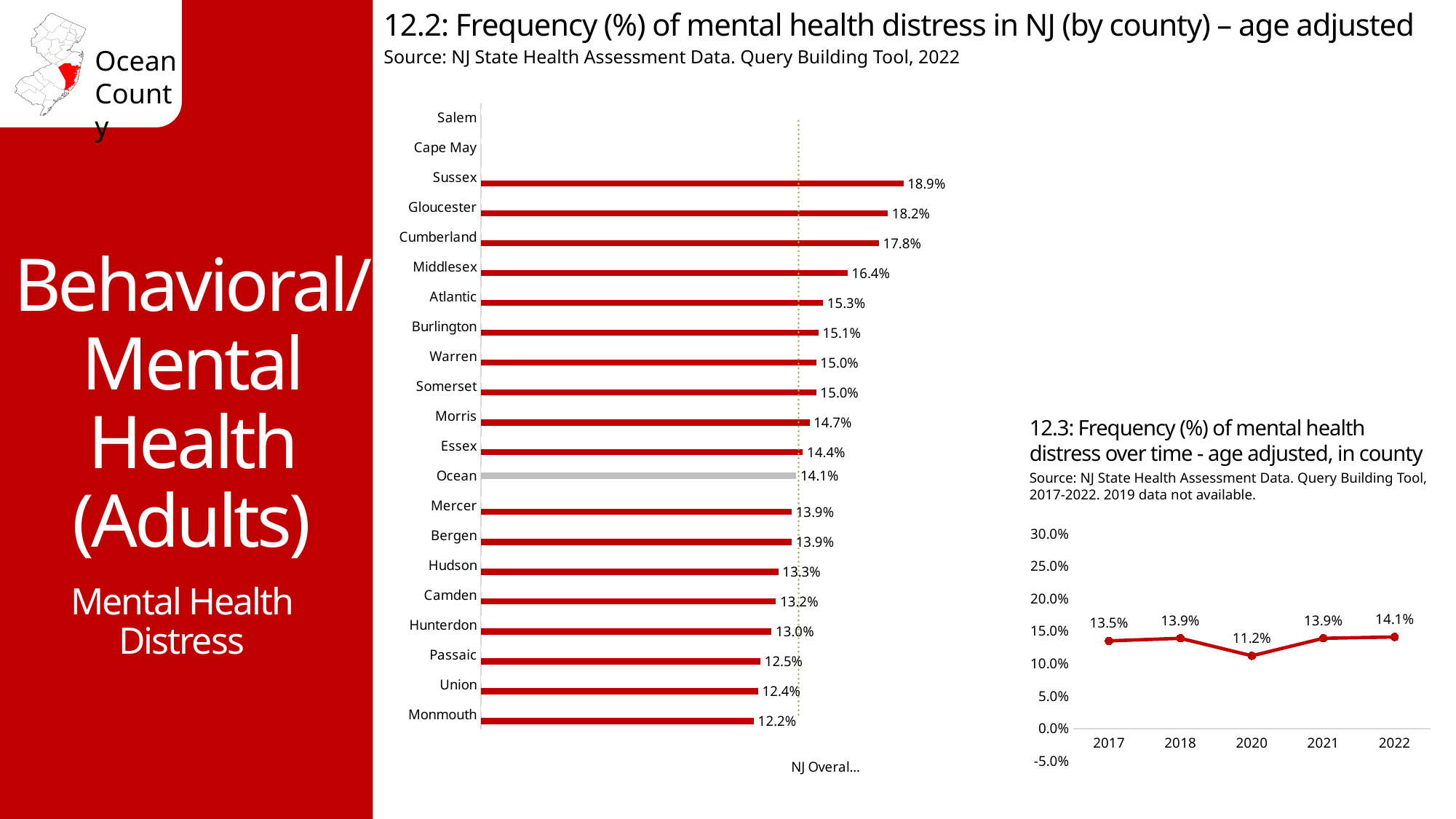
In chart 12.3 (over time), what kind of chart is shown? Line chart In chart 12.2 (by county), which is larger, Middlesex or Atlantic? Middlesex In chart 12.2 (by county), what is the value for Cumberland? 17.8% In chart 12.3 (over time), what is the value for 2020? 11.2% In chart 12.2 (by county), what is the value for Ocean County? 14.1% In chart 12.2 (by county), which county with a plotted bar has the lowest value? Monmouth In chart 12.2 (by county), which county has the highest frequency of mental health distress? Sussex In chart 12.3 (over time), how many data points are plotted? 5 In chart 12.3 (over time), which year has the highest value? 2022 In chart 12.2 (by county), what is the difference between Sussex and Monmouth? 6.7% In chart 12.3 (over time), what is the difference between 2022 and 2020? 2.9% In chart 12.2 (by county), what kind of chart is shown? Bar chart